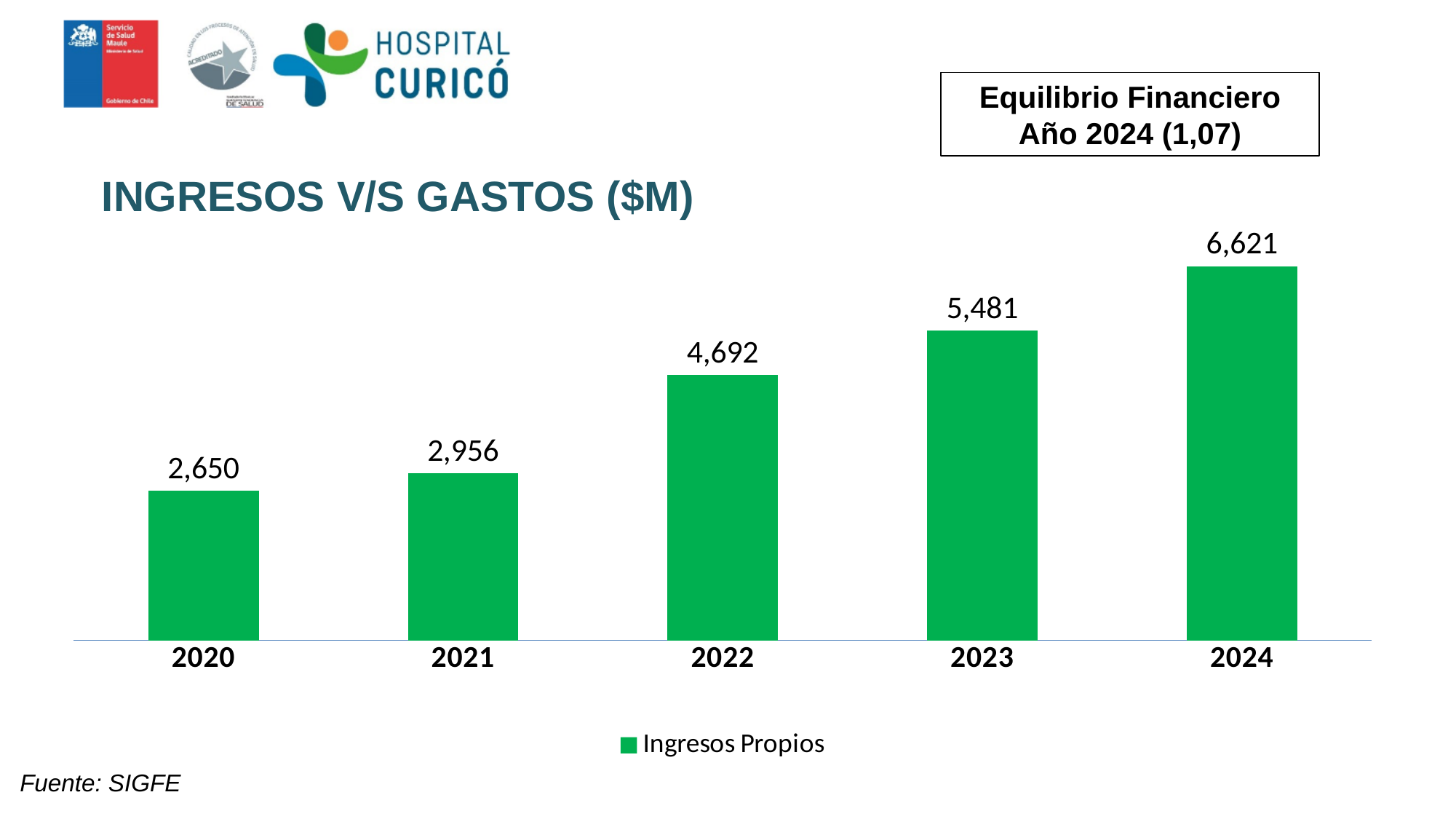
Do the Ingresos Propios values rise or fall from 2020 to 2024? Rise What is the difference between the Ingresos Propios values for 2024 and 2023? 1,140 Which year has the lowest value for Ingresos Propios? 2020 What is the difference between the Ingresos Propios values for 2021 and 2020? 306 Which is larger, the value for 2022 or the value for 2021? 2022 What is the value for Ingresos Propios in 2024? 6,621 How many series does the legend list? 1 What is the value for Ingresos Propios in 2022? 4,692 What kind of chart is shown on the slide? Bar chart What is the value for Ingresos Propios in 2020? 2,650 Which year has the highest value for Ingresos Propios? 2024 How many years are shown on the chart? 5